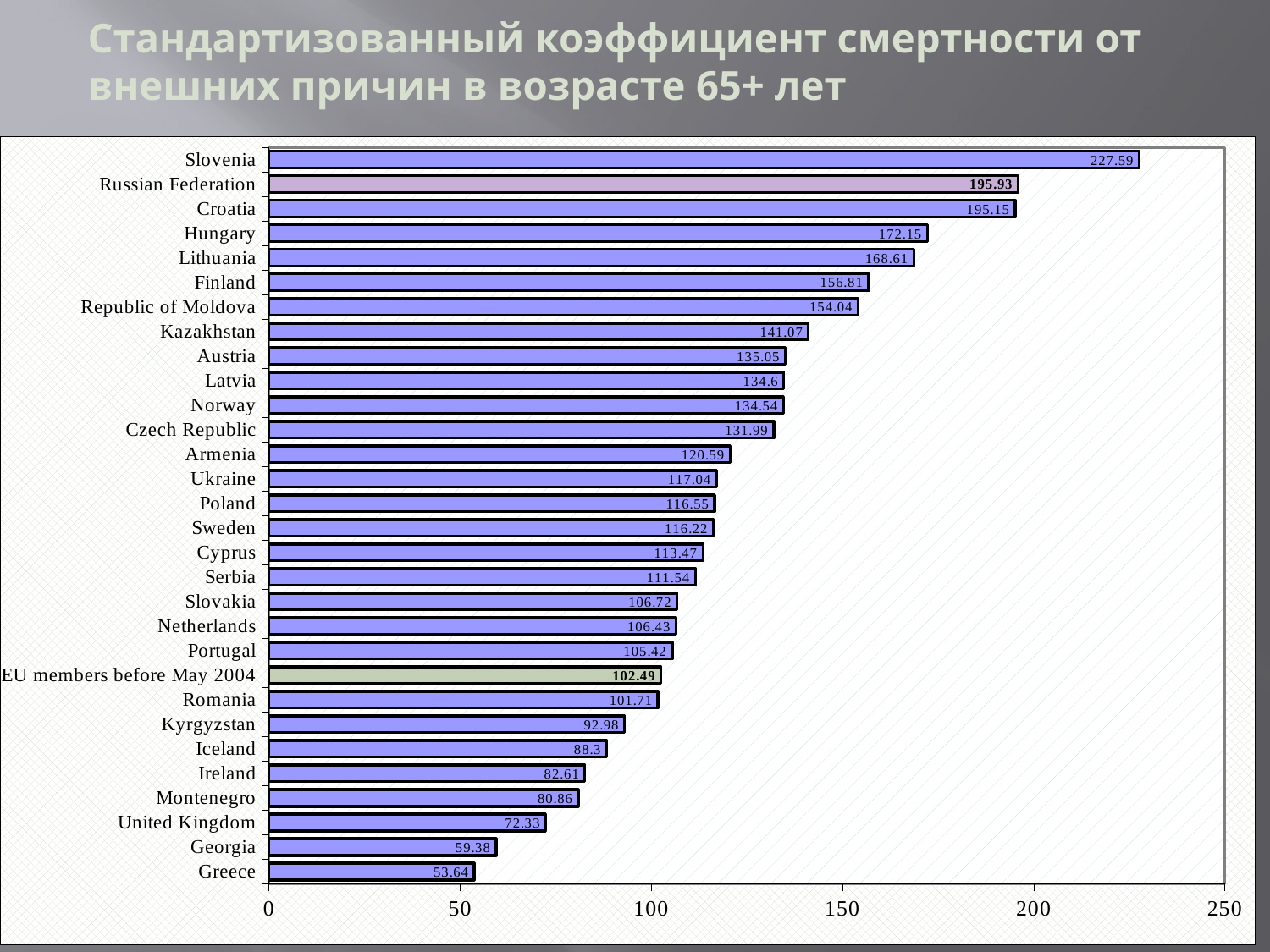
What is the difference between the values for the Russian Federation and EU members before May 2004? 93.44 Is the value for Ukraine greater or less than 100? greater What is the value for Kazakhstan? 141.07 What is the value for EU members before May 2004? 102.49 How many categories are shown in the chart? 30 What is the difference between the values for Slovenia and Greece? 173.95 What kind of chart is shown on the slide? bar chart What is the value for the Russian Federation? 195.93 Which country has the lowest value? Greece Which country has the highest value? Slovenia Which has a larger value, Hungary or Finland? Hungary Which bar is shaded differently from the others besides the Russian Federation? EU members before May 2004